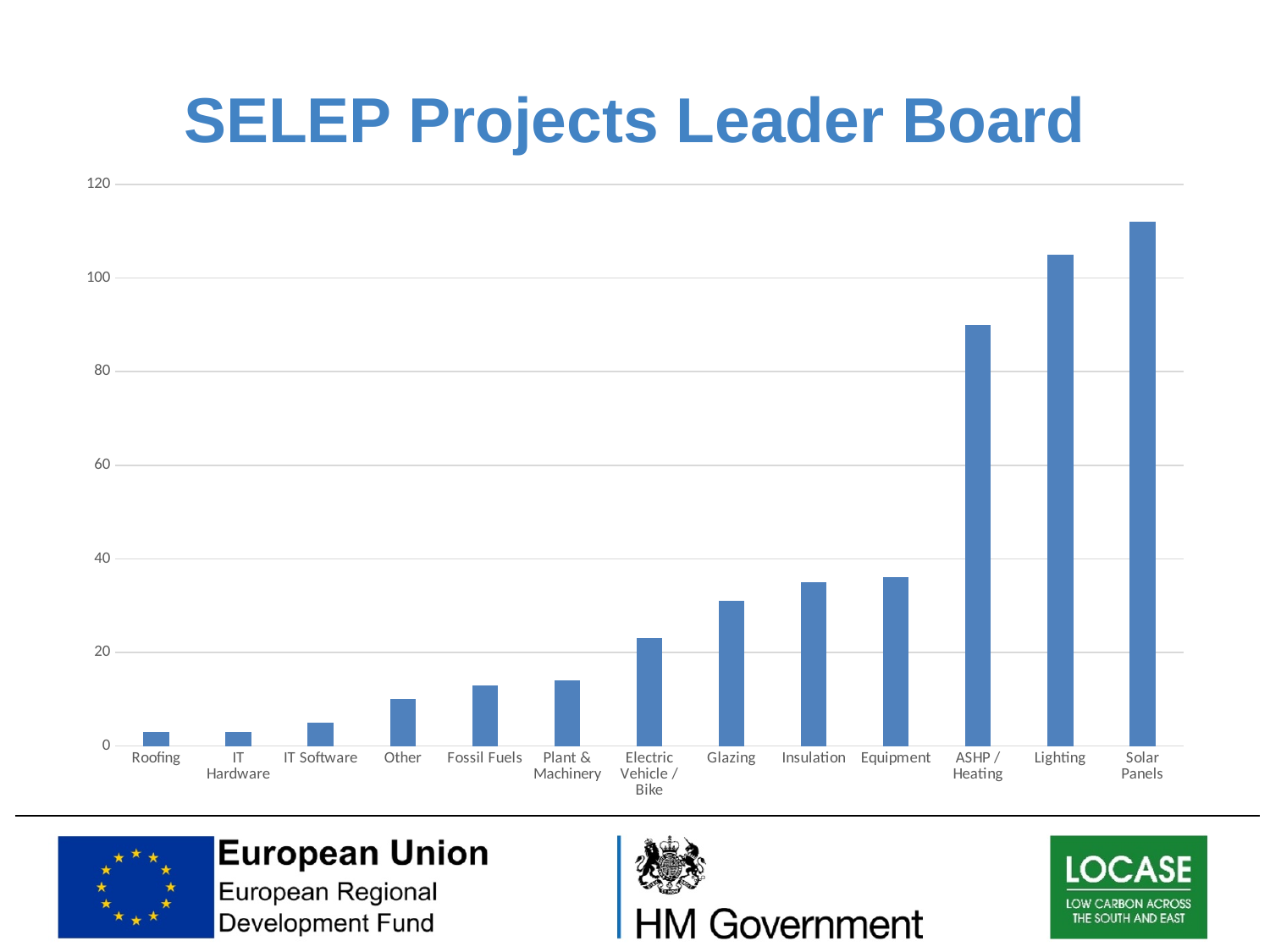
How many categories are shown on the x axis of the chart? 13 Which is larger, the value for Lighting or the value for ASHP / Heating? Lighting Is the value for ASHP / Heating greater or less than 80? greater Which category has the highest value in the chart? Solar Panels Is the value for Electric Vehicle / Bike greater or less than 20? greater Is the value for Other greater or less than 20? less Do the values generally rise or fall moving from left to right along the x axis? rise What type of chart is shown on the slide? bar chart What is the title of the chart? SELEP Projects Leader Board Which is larger, the value for Insulation or the value for Fossil Fuels? Insulation